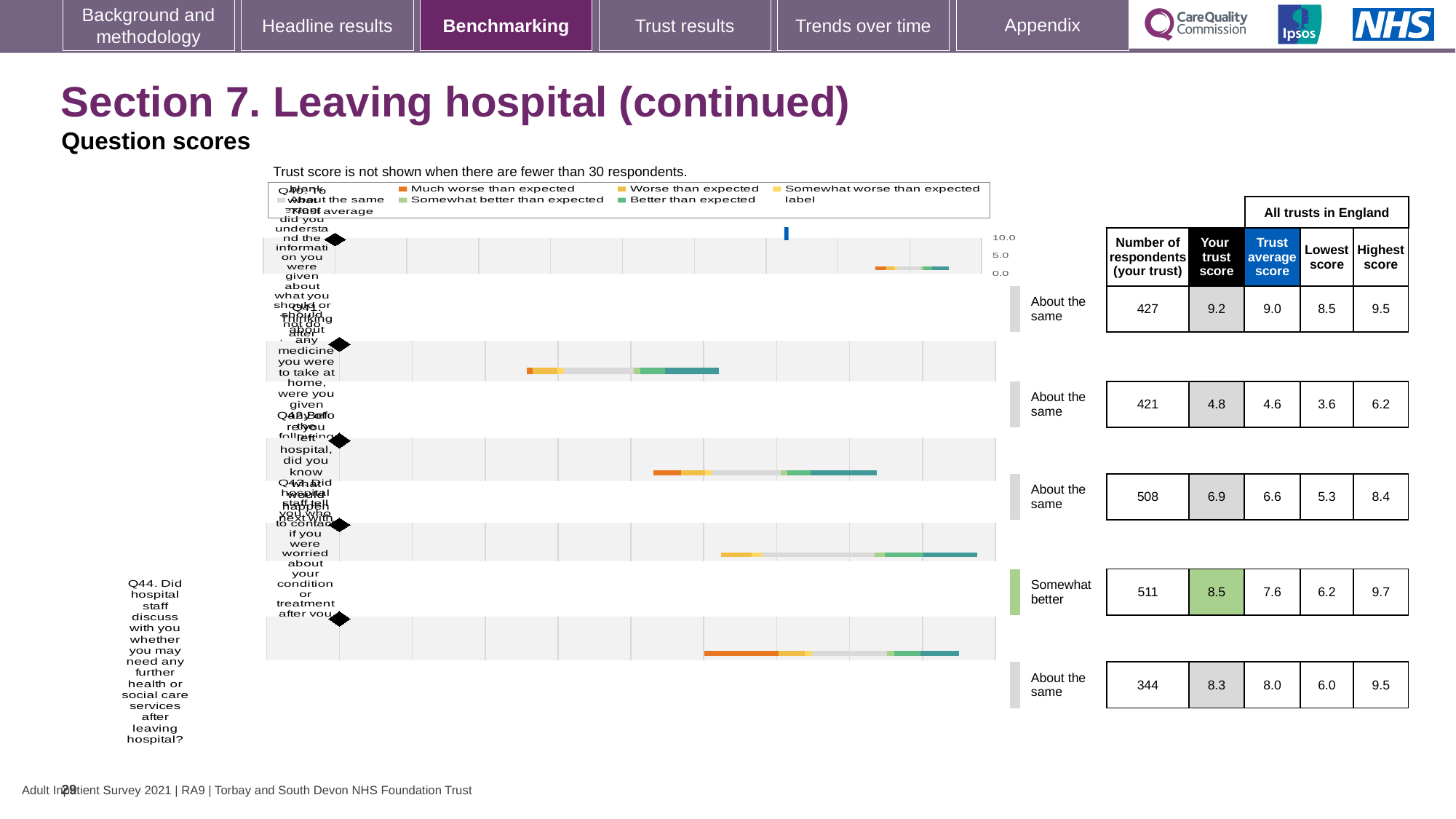
Which question row is rated 'Somewhat better' rather than 'About the same'? the fourth row Which question row has the highest trust score? the first row (9.2) What is the highest score across all trusts in England for Q44? 9.5 Which question row has the lowest trust score? the second row (4.8) How many question rows are plotted in the chart? 5 Which question row has the most respondents? the fourth row (511) Is the trust score for Q44 greater or less than the trust average score for Q44? greater How many respondents answered Q44? 344 What is the difference between the trust score and the trust average score for Q44? 0.3 What kind of chart is shown on the slide? bar chart What is the trust score for Q44 (further health or social care services after leaving hospital)? 8.3 What is the trust average score for Q44? 8.0